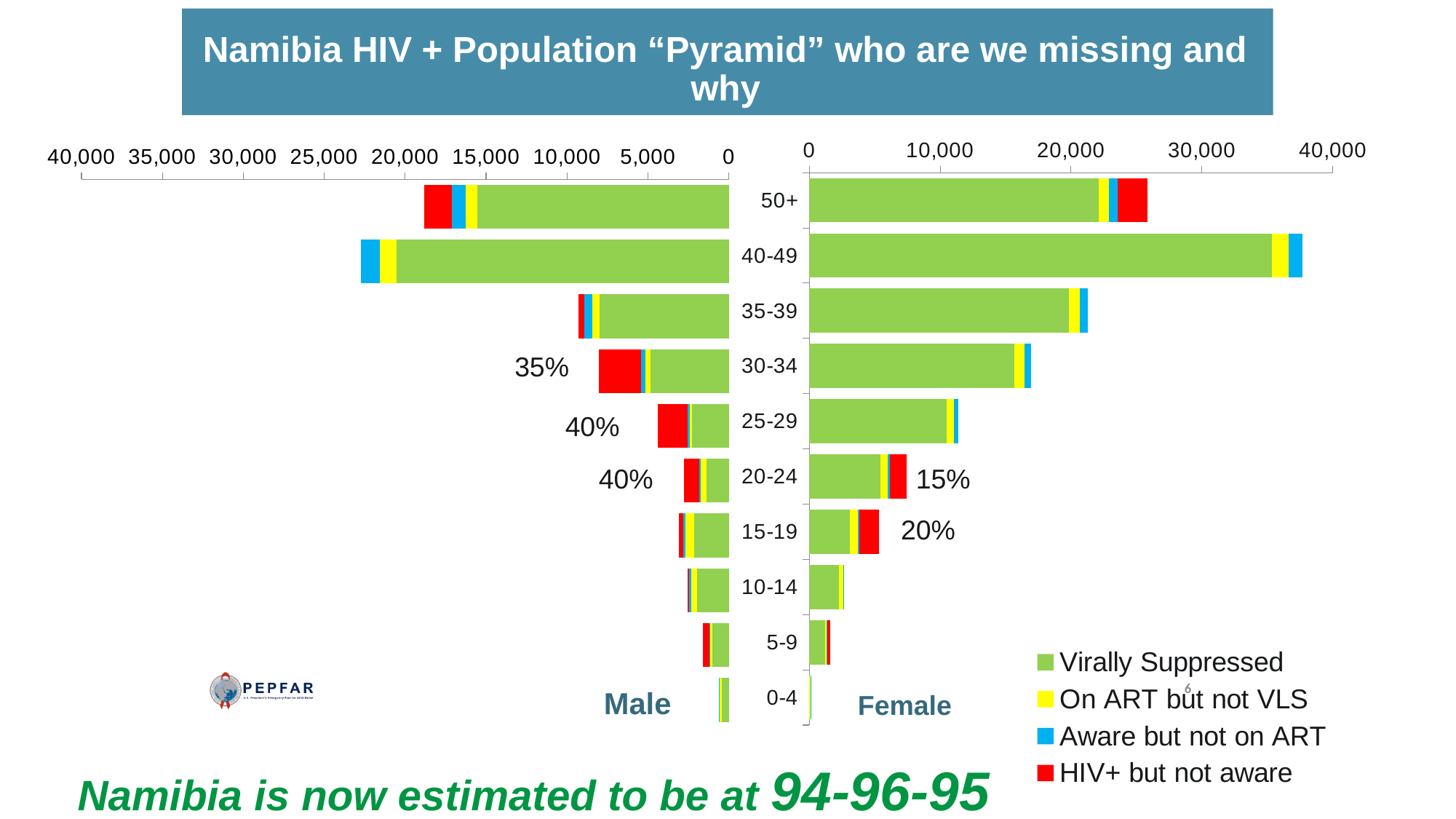
How many age groups are shown on the pyramid? 10 Is the total bar length for Male 30-34 greater or less than 10,000? less On the Male side, which age group has the shortest bar? 0-4 On the Female side, what percentage label is shown next to the 15-19 age group? 20% On the Male side, what percentage label is shown next to the 30-34 age group? 35% Which colour represents 'HIV+ but not aware' in the legend? red How many series does the legend list? 4 On the Female side, which age group has the longest bar? 40-49 What kind of chart is shown on the slide? bar chart On the Male side, what percentage label is shown next to the 25-29 age group? 40% On the Female side, what percentage label is shown next to the 20-24 age group? 15% Is the total bar length for Female 40-49 greater or less than 30,000? greater